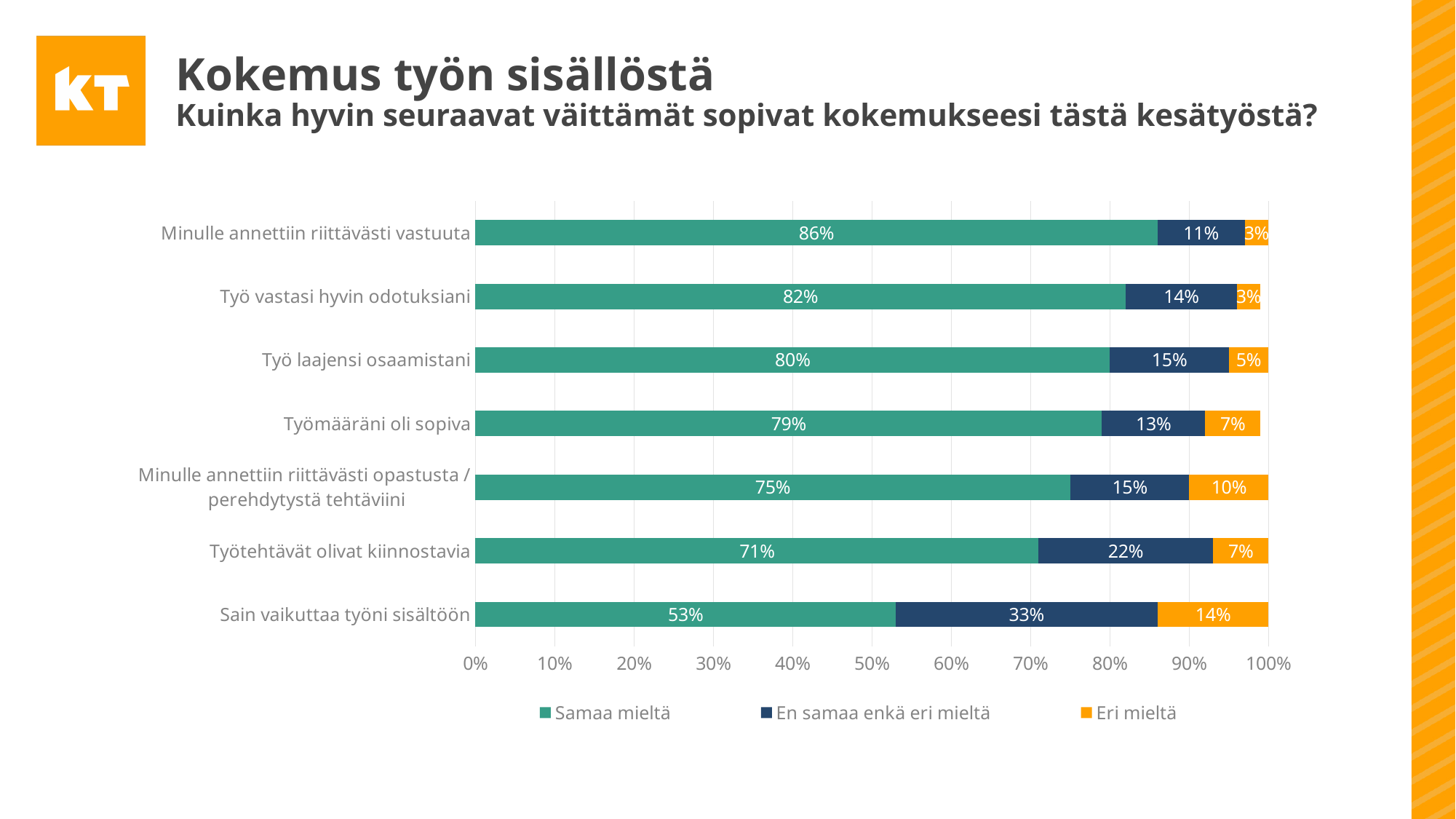
What is the total of the three segments for "Työ laajensi osaamistani"? 100% Which colour represents "Eri mieltä" in the chart? Orange Which statement has the lowest "Samaa mieltä" share? Sain vaikuttaa työni sisältöön What is the "Eri mieltä" value for "Sain vaikuttaa työni sisältöön"? 14% What percentage of respondents agreed (Samaa mieltä) with "Minulle annettiin riittävästi vastuuta"? 86% How many statements (categories) are shown in the chart? 7 What is the "En samaa enkä eri mieltä" value for "Työtehtävät olivat kiinnostavia"? 22% Which has a larger "Eri mieltä" share: "Työmääräni oli sopiva" or "Minulle annettiin riittävästi opastusta / perehdytystä tehtäviini"? Minulle annettiin riittävästi opastusta / perehdytystä tehtäviini What is the difference between the "Samaa mieltä" values for "Työ vastasi hyvin odotuksiani" and "Sain vaikuttaa työni sisältöön"? 29 percentage points How many series does the legend list? 3 Which statement has the highest "Samaa mieltä" share? Minulle annettiin riittävästi vastuuta What kind of chart is shown on the slide? Stacked bar chart